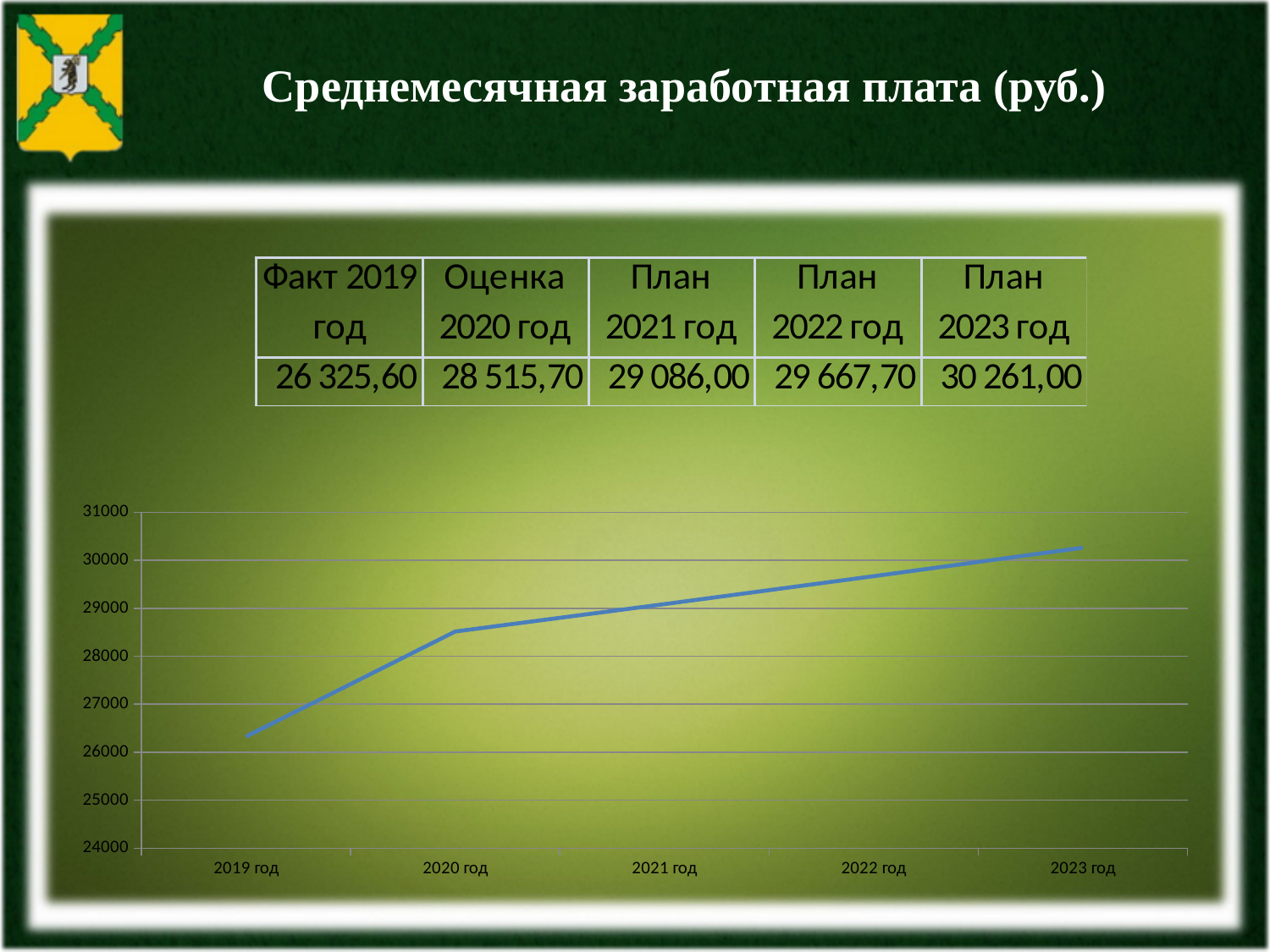
What is the estimated (Оценка) value for 2020 год? 28 515,70 Is the value for 2019 год greater or less than 27000? less Which year has the highest average monthly salary? 2023 год What is the planned average monthly salary for 2023 год? 30 261,00 What is the difference between the 2023 год and 2019 год values? 3 935,40 What is the difference between the 2020 год and 2019 год values? 2 190,10 What kind of chart is shown on the slide? line chart What is the average monthly salary for 2019 год? 26 325,60 Which year has the lowest average monthly salary? 2019 год Do the values rise or fall from 2019 год to 2023 год? rise Which is larger, the value for 2021 год or 2022 год? 2022 год How many years are plotted on the x axis? 5